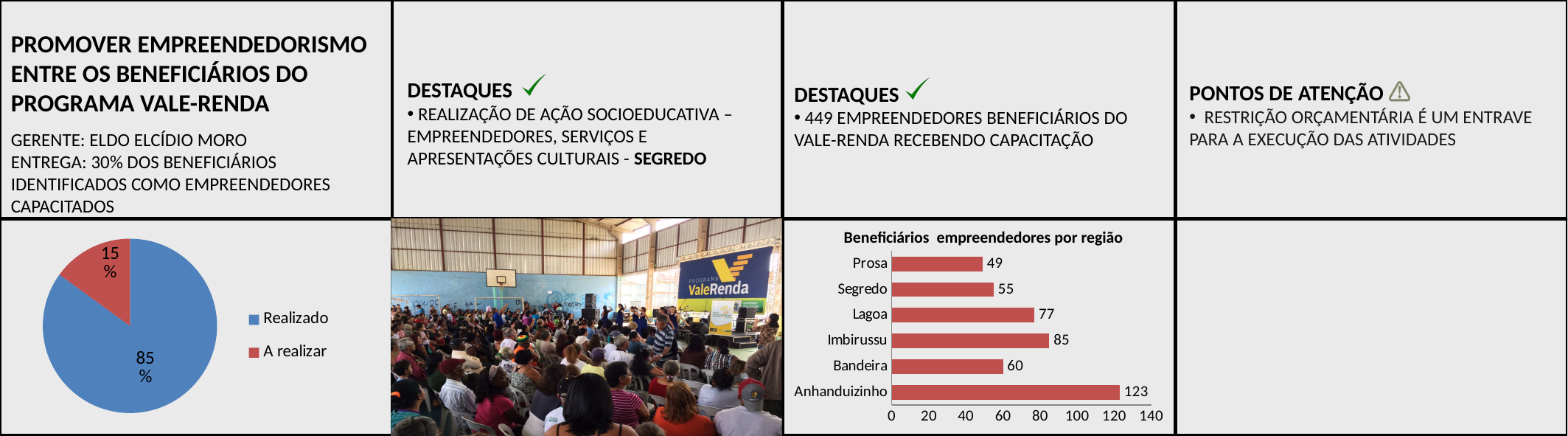
In the pie chart on the left of the slide, what share is labelled 'A realizar'? 15% In the bar chart 'Beneficiários empreendedores por região', what is the difference between Imbirussu and Bandeira? 25 In the bar chart 'Beneficiários empreendedores por região', which is larger, Segredo or Lagoa? Lagoa In the pie chart on the left of the slide, what share is labelled 'Realizado'? 85% In the bar chart 'Beneficiários empreendedores por região', which region has the lowest value? Prosa In the bar chart 'Beneficiários empreendedores por região', what is the value for Anhanduizinho? 123 In the bar chart 'Beneficiários empreendedores por região', is the value for Anhanduizinho greater or less than 100? greater In the bar chart 'Beneficiários empreendedores por região', what is the value for Lagoa? 77 In the bar chart 'Beneficiários empreendedores por região', which region has the highest value? Anhanduizinho How many entries does the legend of the pie chart on the left of the slide list? 2 How many regions are shown in the bar chart 'Beneficiários empreendedores por região'? 6 What kind of chart is 'Beneficiários empreendedores por região'? bar chart